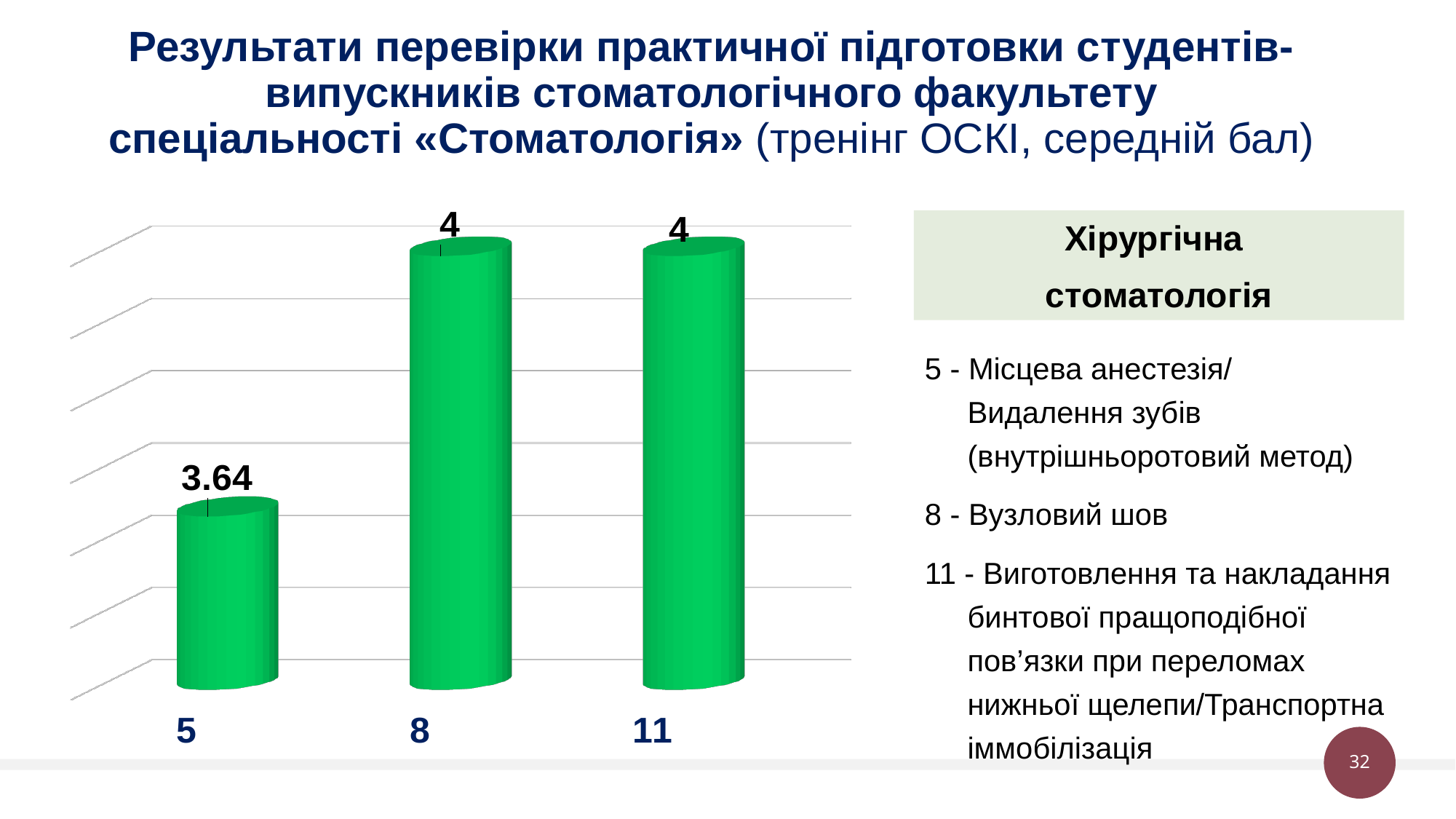
What is the value shown for category 8? 4 What is the difference between the values for category 8 and category 5? 0.36 Which category has the lowest value? 5 How many bars are shown on the chart? 3 What is the value shown for category 11? 4 What kind of chart is shown on the slide? Bar chart What is the value shown for category 5? 3.64 Which has the larger value, category 5 or category 11? 11 What is the highest value shown on the chart? 4 What colour are the bars on the chart? Green Do the values rise or fall from category 5 to category 8? Rise Do the values for categories 8 and 11 differ? No, both are 4